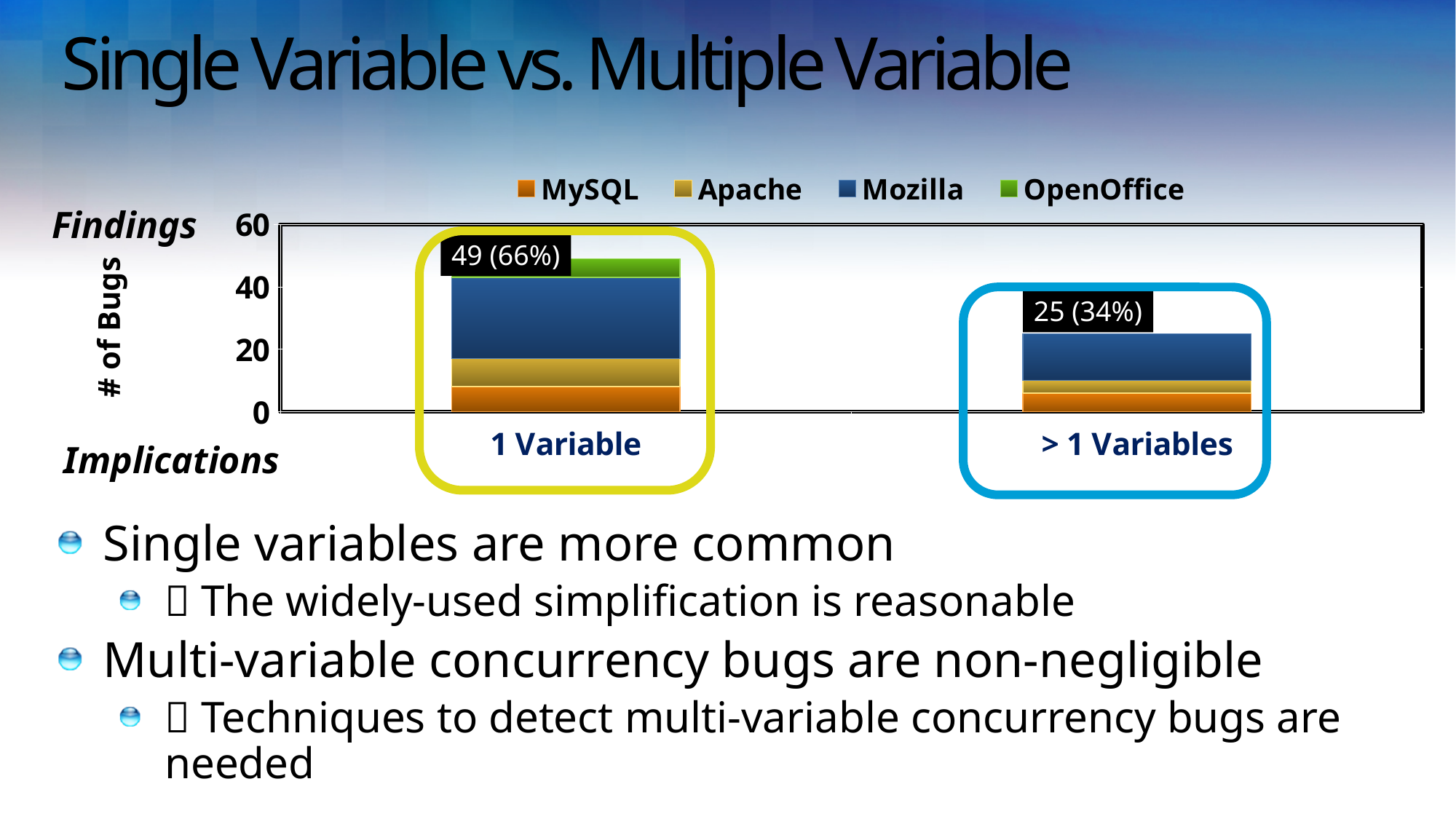
How many series does the chart legend list? 4 What is the total number of bugs labelled for the "> 1 Variables" bar? 25 (34%) What is the total number of bugs labelled for the "1 Variable" bar? 49 (66%) What kind of chart is shown on the slide? stacked bar chart Which category has the lower total number of bugs? > 1 Variables Is the total for the "> 1 Variables" bar greater or less than 40? less Which category has the higher total number of bugs? 1 Variable Is the total for the "1 Variable" bar greater or less than 40? greater How many categories are shown on the x axis of the chart? 2 Which series is shown in green in the chart legend? OpenOffice What is the label of the y axis of the chart? # of Bugs What is the difference between the total bugs for "1 Variable" and "> 1 Variables"? 24